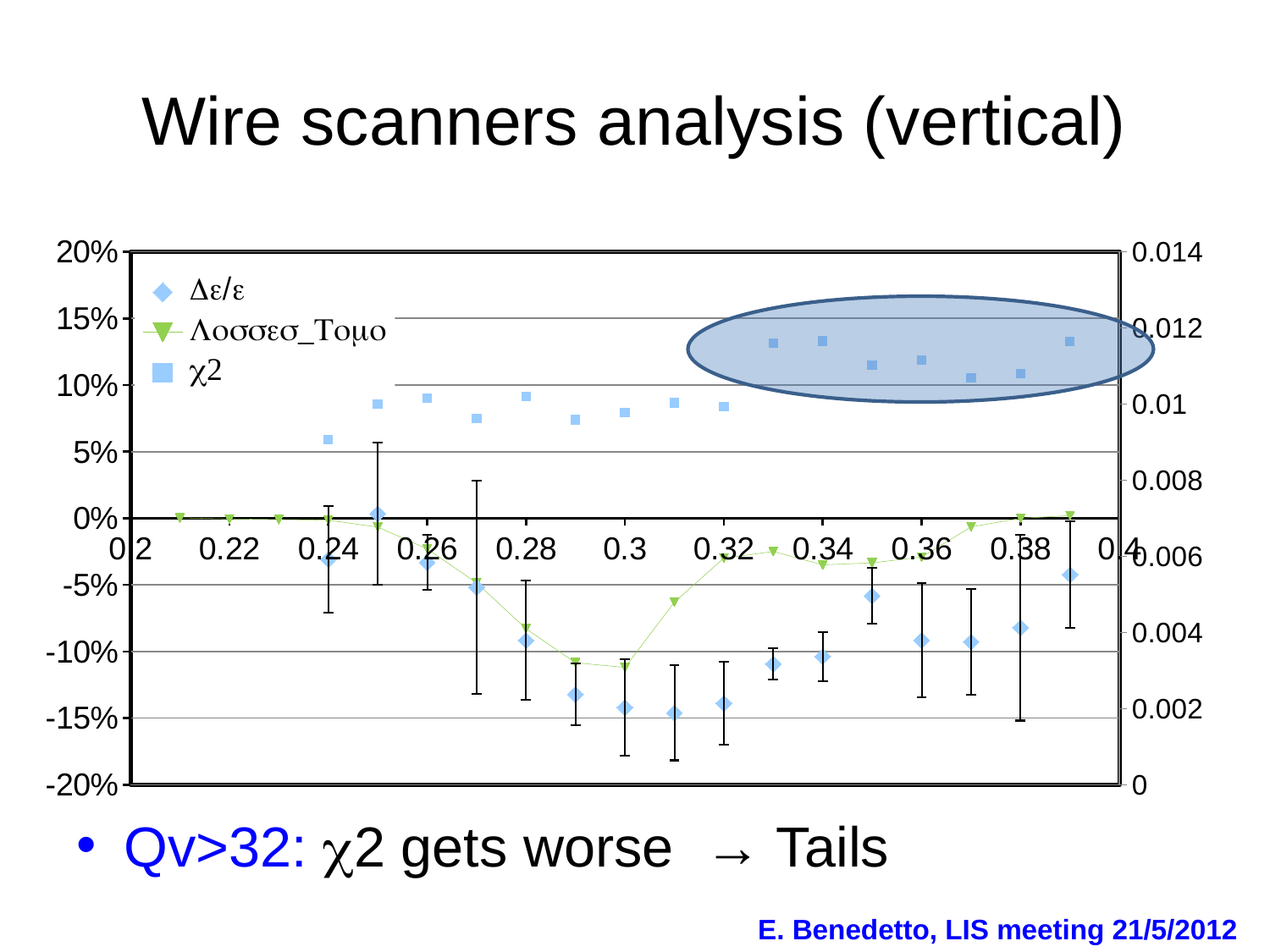
How many χ2 data points are plotted? 16 Which series is drawn with green triangle markers? Λοσσεσ_Τομο Is the Δε/ε value at x = 0.25 greater or less than -5%? greater Which is larger, the Δε/ε value at x = 0.30 or at x = 0.36? 0.36 How many series does the chart legend list? 3 Is the χ2 value at x = 0.24 greater or less than 0.01 on the right axis? less Is the Δε/ε value at x = 0.31 greater or less than -10%? less Do the Δε/ε values rise or fall as x goes from 0.25 to 0.31? fall What kind of chart is shown on the slide? scatter chart Which is larger, the χ2 value at x = 0.24 or at x = 0.34? 0.34